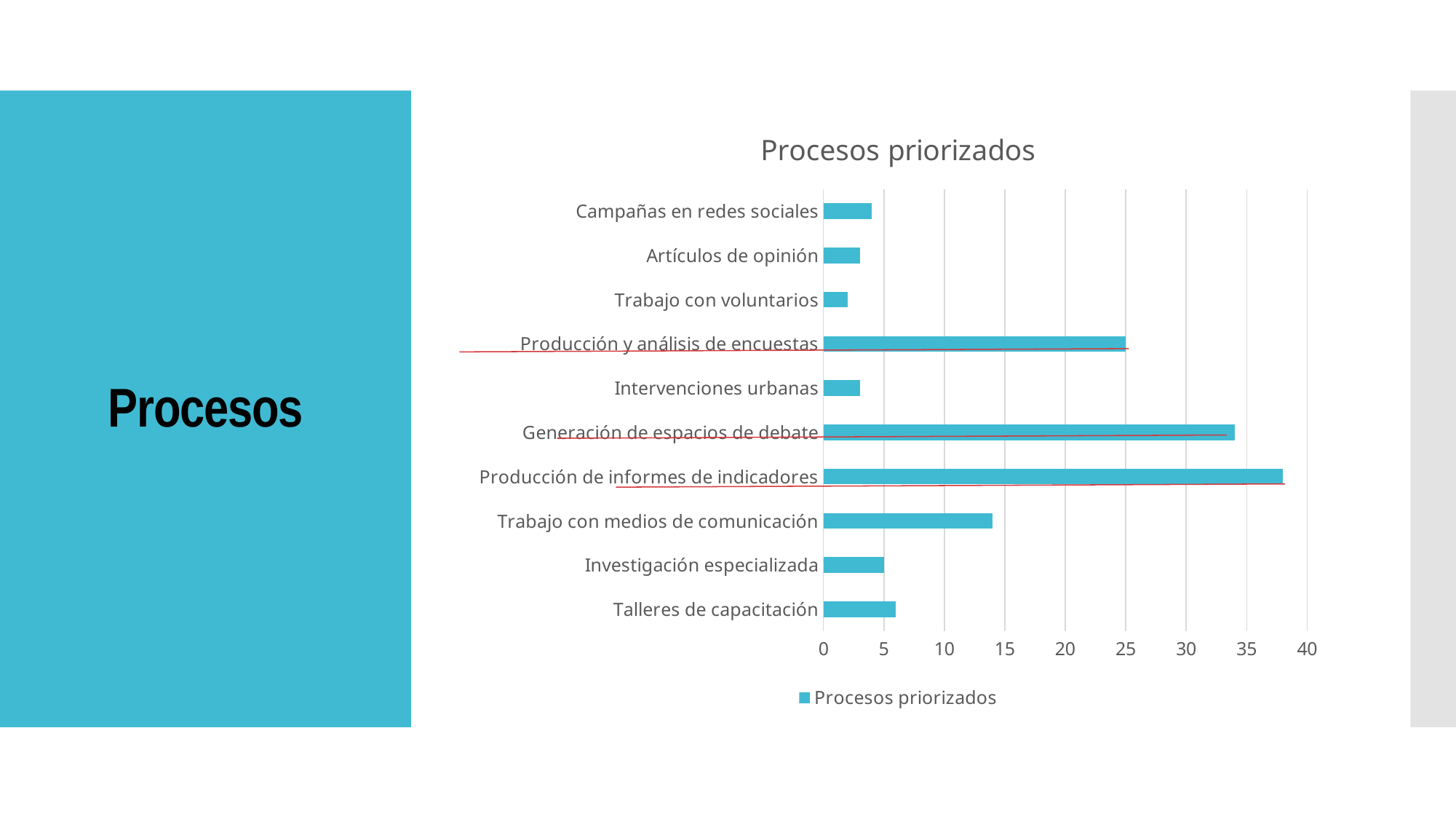
Which category has the lowest value? Trabajo con voluntarios What is the title of the chart? Procesos priorizados How many categories are shown in the chart? 10 Is the value for Trabajo con medios de comunicación greater or less than 10? greater Which is larger: Producción y análisis de encuestas or Talleres de capacitación? Producción y análisis de encuestas What type of chart is shown on the slide? Bar chart Is the value for Campañas en redes sociales greater or less than 5? less How many series does the legend list? 1 Which is larger: Generación de espacios de debate or Trabajo con medios de comunicación? Generación de espacios de debate Which category has the highest value? Producción de informes de indicadores Is the value for Generación de espacios de debate greater or less than 30? greater